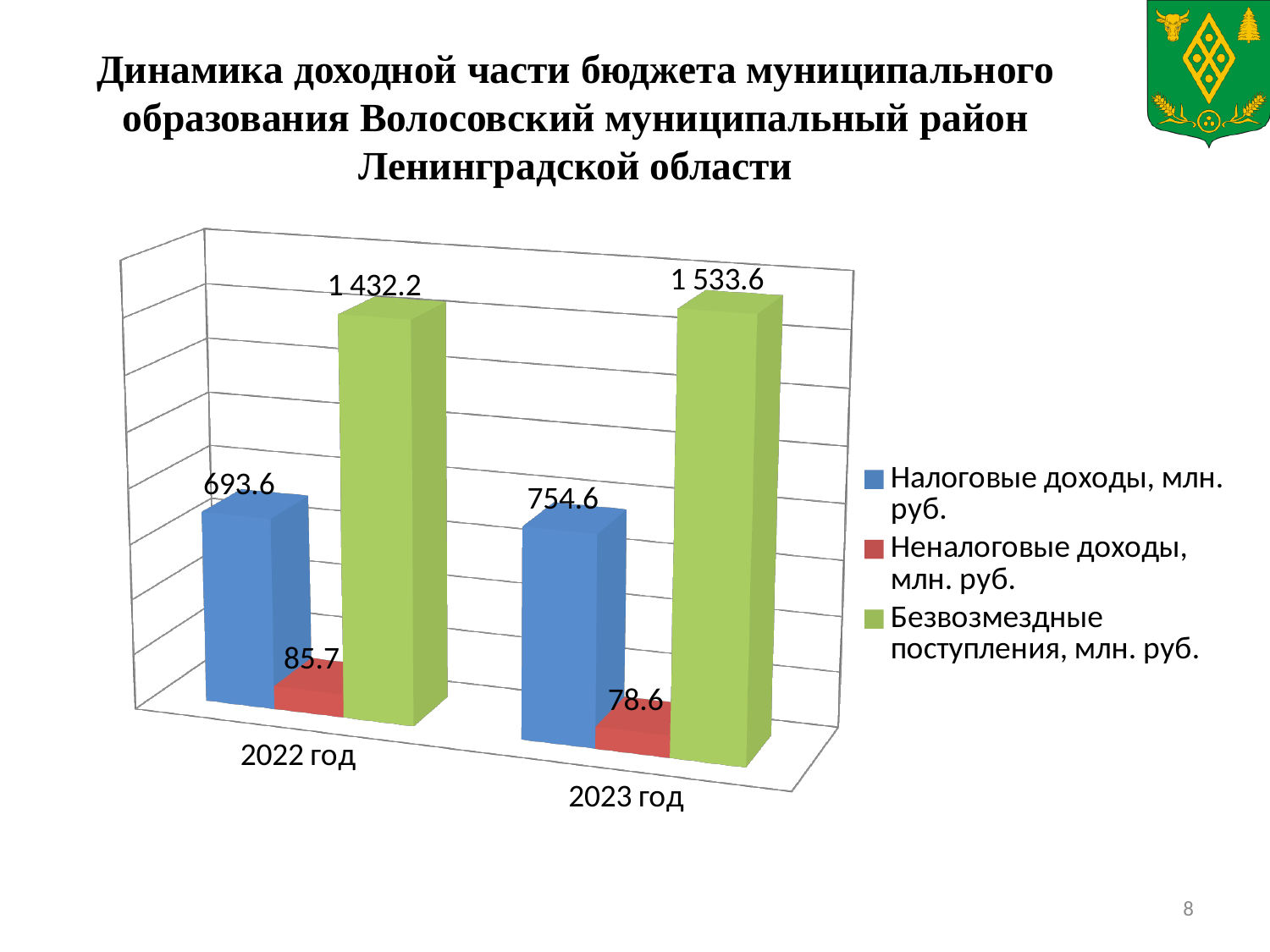
Which is larger: Неналоговые доходы, млн. руб. in 2022 год or in 2023 год? 2022 год How many categories are shown on the x axis? 2 Which series has the lowest value in 2022 год? Неналоговые доходы, млн. руб. What is the value of Неналоговые доходы, млн. руб. for 2023 год? 78.6 What is the value of Безвозмездные поступления, млн. руб. for 2022 год? 1 432.2 How many series does the legend list? 3 What is the value of Налоговые доходы, млн. руб. for 2022 год? 693.6 Which series has the highest value in 2023 год? Безвозмездные поступления, млн. руб. What is the value of Безвозмездные поступления, млн. руб. for 2023 год? 1 533.6 What is the difference between Налоговые доходы, млн. руб. in 2023 год and in 2022 год? 61.0 What kind of chart is shown on the slide? Bar chart What is the difference between Безвозмездные поступления, млн. руб. in 2023 год and in 2022 год? 101.4